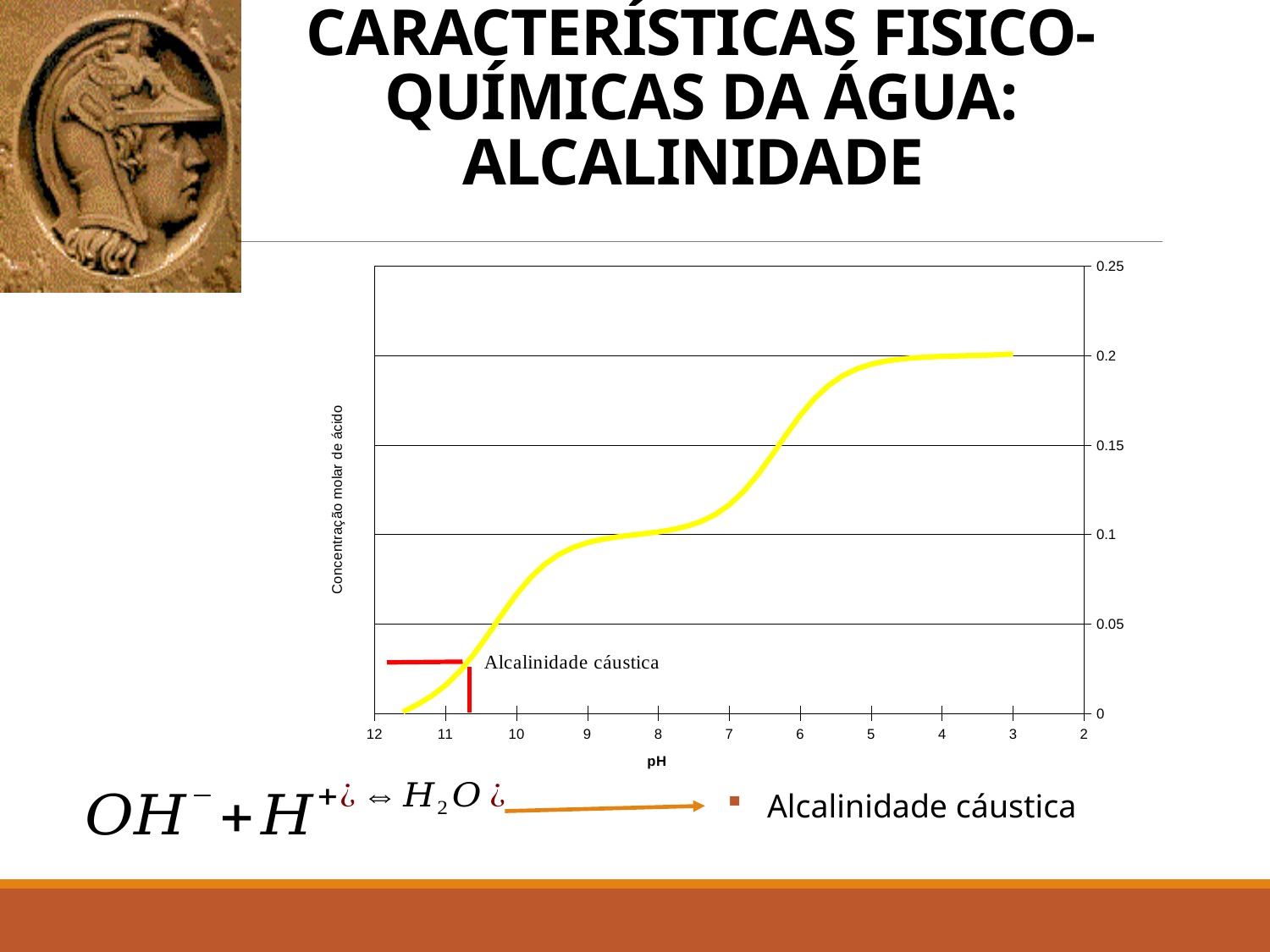
What is the highest value shown on the y axis of the chart? 0.25 Which is larger, the value of the curve at pH 4 or at pH 9? pH 4 Is the value of the curve at pH 3 greater or less than 0.15? greater Is the value of the curve at pH 8 greater or less than 0.15? less Is the value of the curve at pH 10 greater or less than 0.1? less What kind of chart is shown on the slide? line chart What is the label of the y axis of the chart? Concentração molar de ácido What is the label of the x axis of the chart? pH Does the plotted curve rise or fall from left to right across the chart? rise How many pH tick labels are shown along the x axis? 11